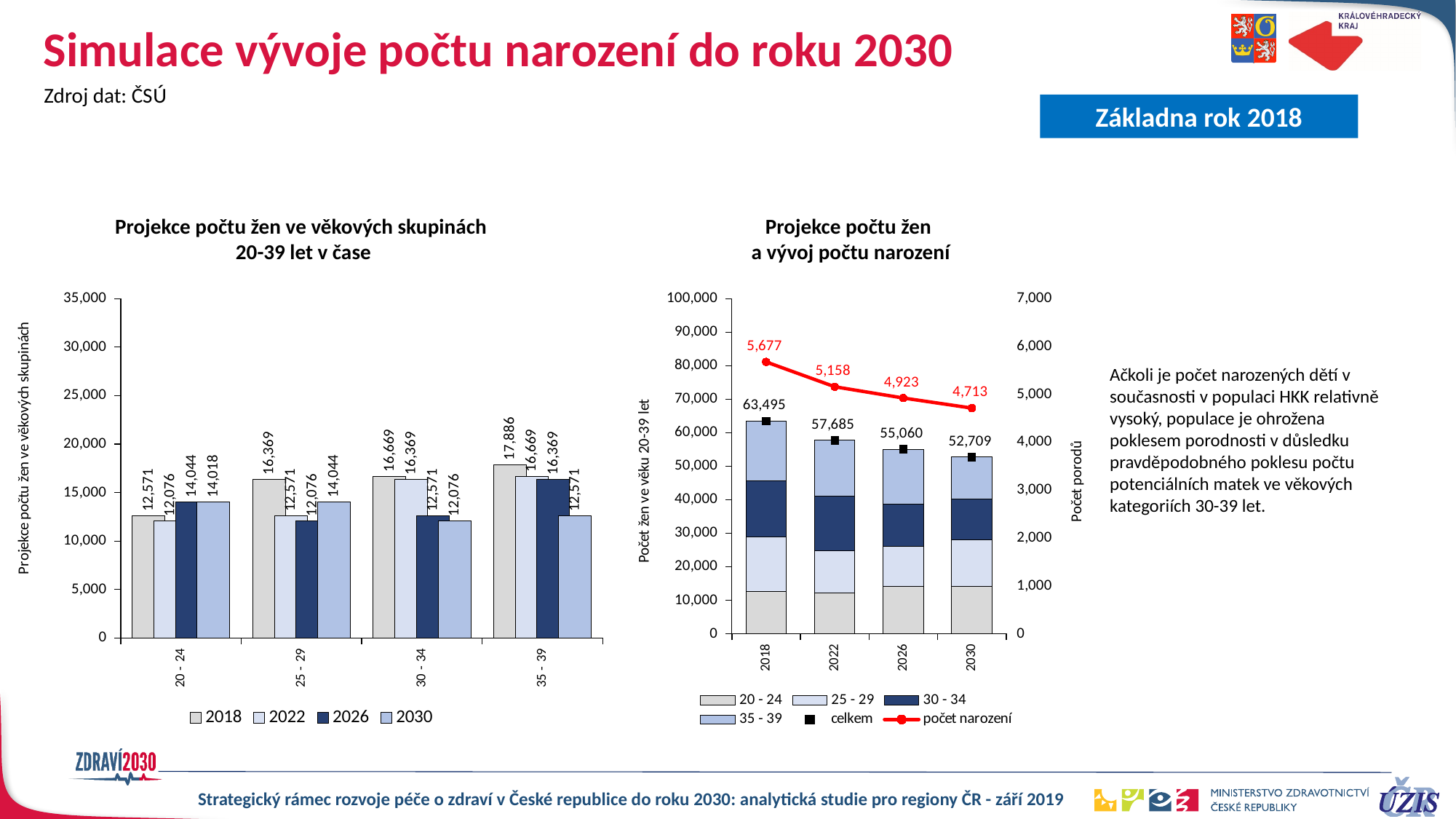
In the left chart 'Projekce počtu žen ve věkových skupinách 20-39 let v čase', which age group has the highest 2018 value? 35 - 39 In the right chart 'Projekce počtu žen a vývoj počtu narození', what is the value of 'počet narození' for 2022? 5,158 In the right chart 'Projekce počtu žen a vývoj počtu narození', what is the 'celkem' total for 2026? 55,060 In the left chart 'Projekce počtu žen ve věkových skupinách 20-39 let v čase', what is the difference between the 2018 and 2030 values for the 35 - 39 age group? 5,315 In the right chart 'Projekce počtu žen a vývoj počtu narození', what is the difference between the 'celkem' totals for 2018 and 2030? 10,786 In the left chart 'Projekce počtu žen ve věkových skupinách 20-39 let v čase', which is larger for the 25 - 29 age group: the 2018 value or the 2030 value? 2018 How many age-group categories are shown on the x axis of the left chart 'Projekce počtu žen ve věkových skupinách 20-39 let v čase'? 4 In the left chart 'Projekce počtu žen ve věkových skupinách 20-39 let v čase', what is the 2018 value for the 35 - 39 age group? 17,886 In the right chart 'Projekce počtu žen a vývoj počtu narození', does the 'počet narození' line rise or fall from 2018 to 2030? Falls How many series does the legend of the left chart 'Projekce počtu žen ve věkových skupinách 20-39 let v čase' list? 4 In the left chart 'Projekce počtu žen ve věkových skupinách 20-39 let v čase', what is the 2030 value for the 20 - 24 age group? 14,018 What kind of chart is the left chart 'Projekce počtu žen ve věkových skupinách 20-39 let v čase'? Bar chart